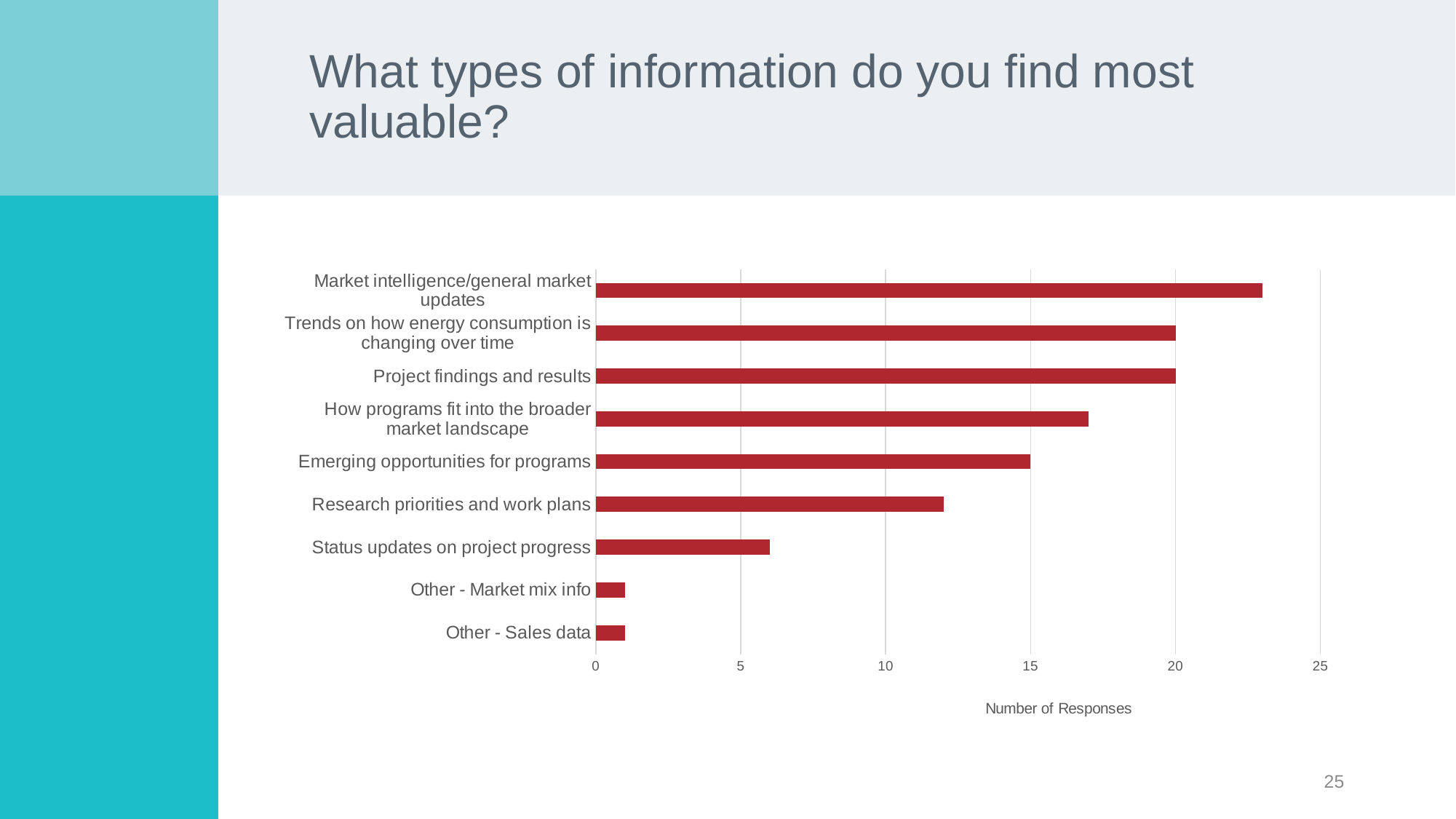
What is the label of the horizontal axis? Number of Responses What is the number of responses for 'Emerging opportunities for programs'? 15 Is the value for 'Status updates on project progress' greater or less than 10? less Is the value for 'Market intelligence/general market updates' greater or less than 20? greater What is the number of responses for 'Trends on how energy consumption is changing over time'? 20 Is the value for 'Research priorities and work plans' greater or less than 10? greater What kind of chart is shown on the slide? bar chart Which has more responses: 'How programs fit into the broader market landscape' or 'Research priorities and work plans'? How programs fit into the broader market landscape Which category has the highest number of responses? Market intelligence/general market updates What is the number of responses for 'Project findings and results'? 20 How many categories are plotted in the chart? 9 What is the title of the slide containing the chart? What types of information do you find most valuable?